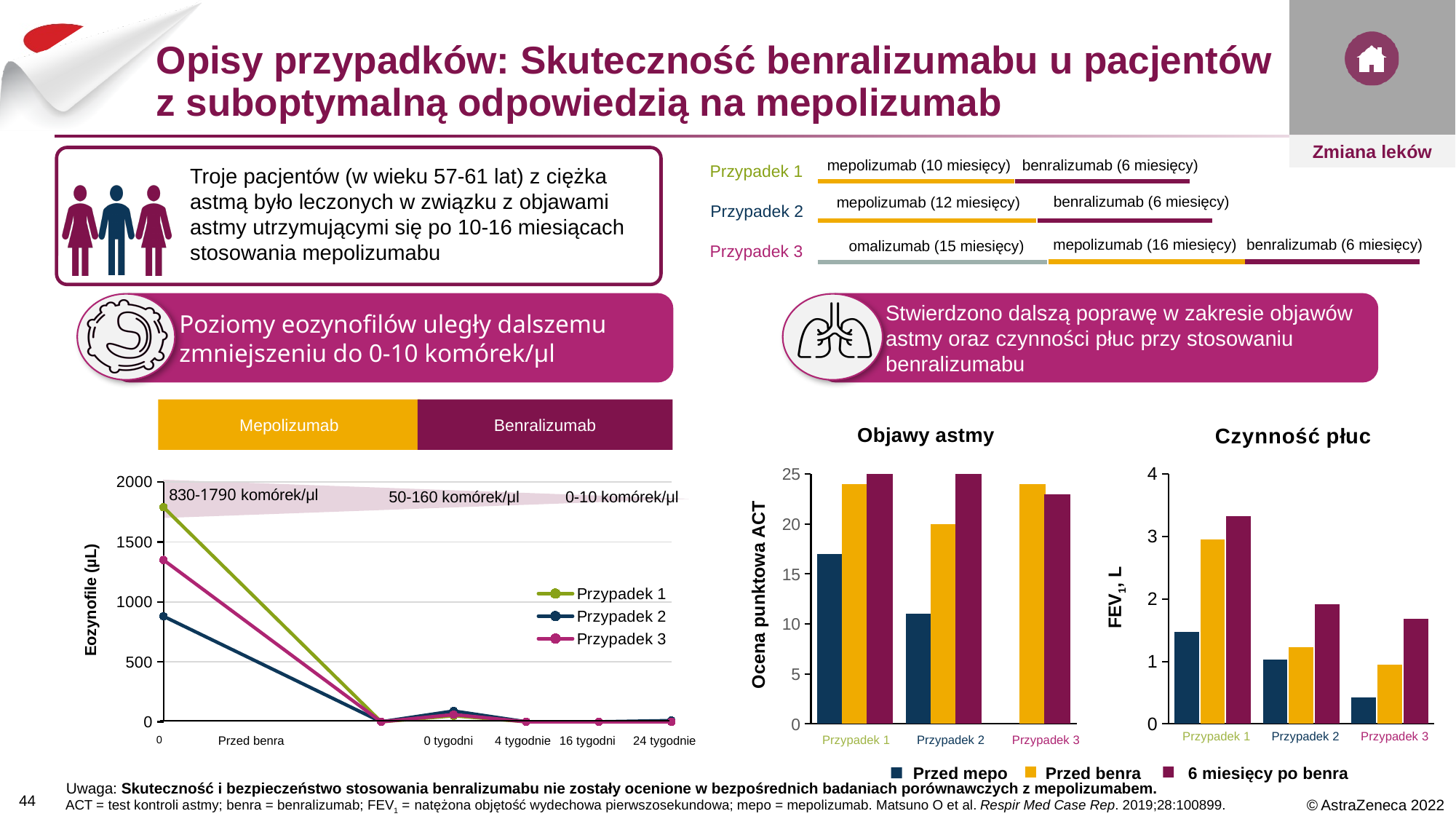
In the 'Objawy astmy' chart, which has the larger 'Przed mepo' value, Przypadek 1 or Przypadek 2? Przypadek 1 What kind of chart is the 'Objawy astmy' chart? bar chart In the 'Eozynofile (µL)' line chart, does the Przypadek 1 line rise or fall from its first point to the '0 tygodni' point? fall In the 'Objawy astmy' chart, what is the 'Przed benra' value for Przypadek 2? 20 How many series does the shared legend below the 'Objawy astmy' and 'Czynność płuc' charts list? 3 In the 'Czynność płuc' chart, is the '6 miesięcy po benra' value for Przypadek 1 greater or less than 3? greater In the 'Czynność płuc' chart, is the 'Przed mepo' value for Przypadek 3 greater or less than 1? less In the 'Czynność płuc' chart, which case has the highest '6 miesięcy po benra' value? Przypadek 1 How many series does the legend of the 'Eozynofile (µL)' line chart list? 3 What kind of chart is the 'Eozynofile (µL)' chart on the left? line chart How many categories are shown on the x axis of the 'Objawy astmy' chart? 3 In the 'Objawy astmy' chart, what is the '6 miesięcy po benra' value for Przypadek 1? 25